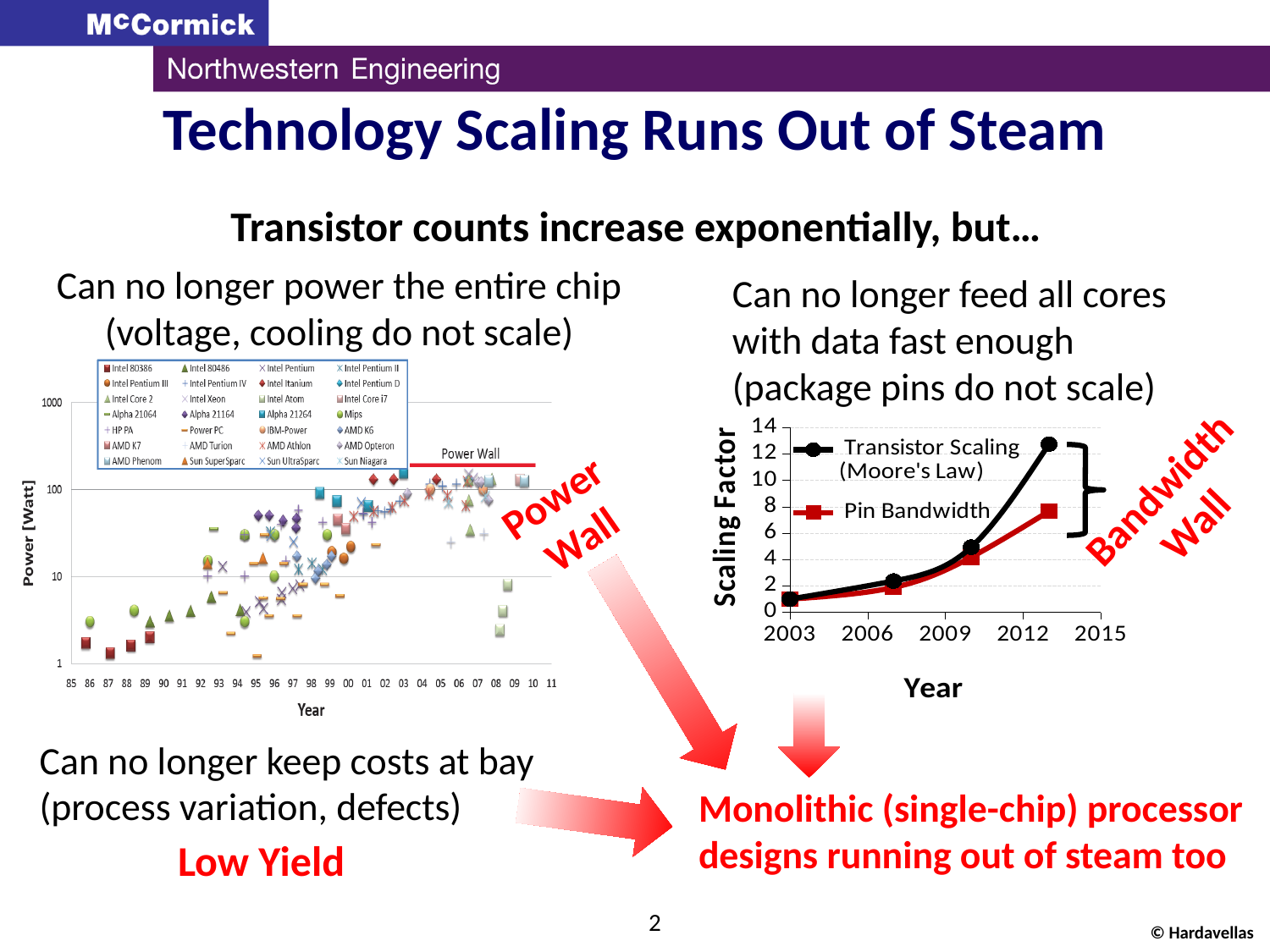
What kind of chart is the left-hand chart with the y axis labelled Power [Watt]? scatter plot In the Scaling Factor chart, is the Transistor Scaling (Moore's Law) value at the last plotted point greater or less than 10? greater In the Scaling Factor chart, is the Pin Bandwidth value at the last plotted point greater or less than 6? greater How many series does the legend of the Scaling Factor chart list? 2 In the Scaling Factor chart, do the Transistor Scaling values rise or fall as the year increases? rise What is the y-axis title of the right-hand line chart? Scaling Factor In the Scaling Factor chart, is the Pin Bandwidth value at the last plotted point greater or less than 10? less What kind of chart is the right-hand chart with the x axis labelled Year and the y axis labelled Scaling Factor? line chart What is the x-axis title of the Power [Watt] chart? Year In the Power [Watt] chart, do the plotted power values generally rise or fall as the year increases? rise How many data points are plotted for the Pin Bandwidth series in the Scaling Factor chart? 4 In the Scaling Factor chart, which series has the higher value at the last plotted year (around 2013)? Transistor Scaling (Moore's Law)